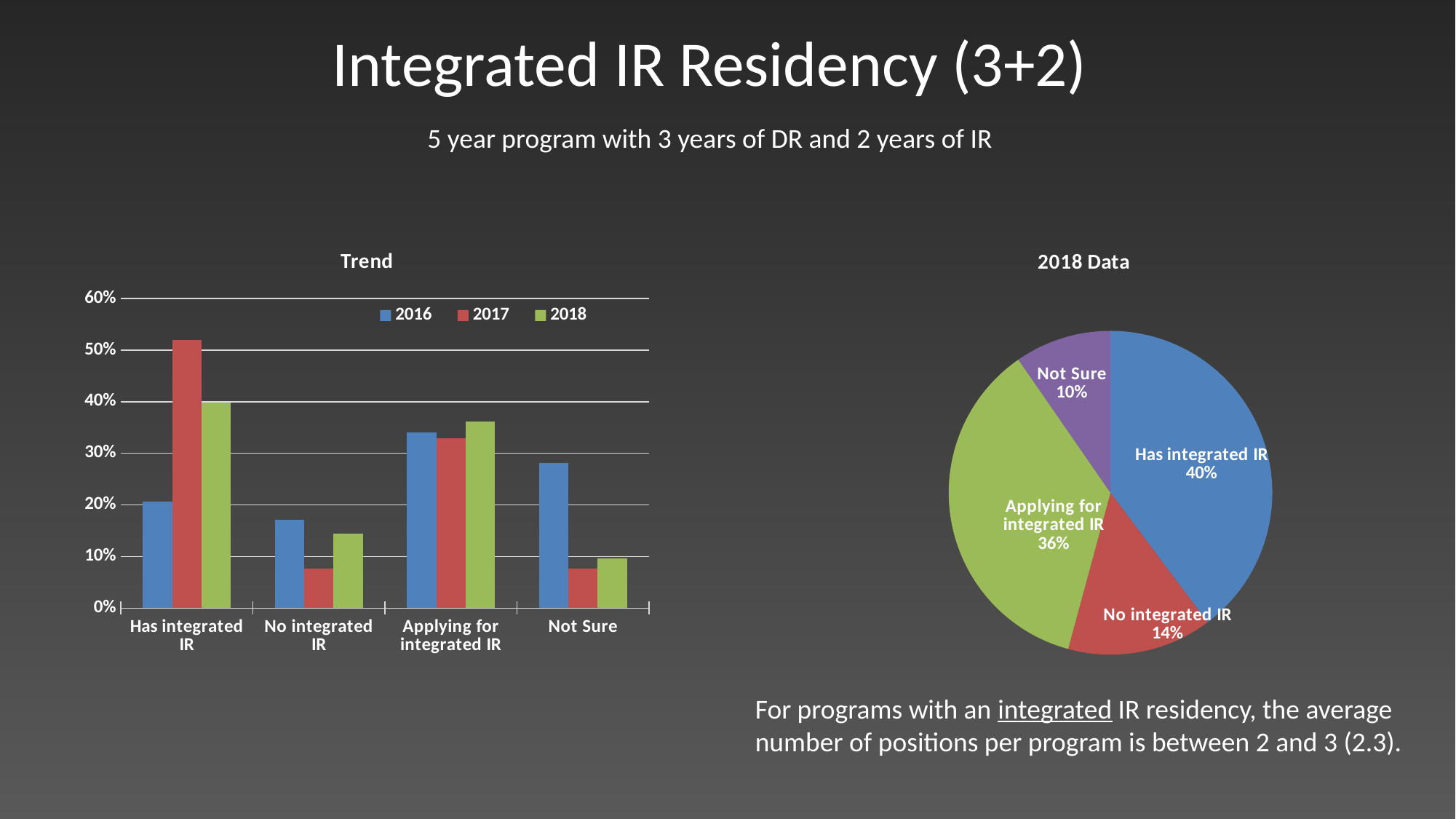
How many series does the legend of the Trend chart list? 3 What kind of chart is the '2018 Data' chart? Pie chart In the Trend chart, is the 2016 value for 'Not Sure' greater or less than 20%? greater In the 2018 Data pie chart, what share of programs has an integrated IR residency? 40% In the 2018 Data pie chart, what is the difference between the 'Has integrated IR' share and the 'No integrated IR' share? 26% In the 2018 Data pie chart, which category has the largest slice? Has integrated IR What kind of chart is the 'Trend' chart? Bar chart In the Trend chart, which is larger for 'Not Sure': the 2016 value or the 2018 value? 2016 In the 2018 Data pie chart, what percentage of programs are applying for integrated IR? 36% In the 2018 Data pie chart, how many slices are there? 4 In the 2018 Data pie chart, which category has the smallest slice? Not Sure In the Trend chart, which year has the highest bar for 'Has integrated IR'? 2017